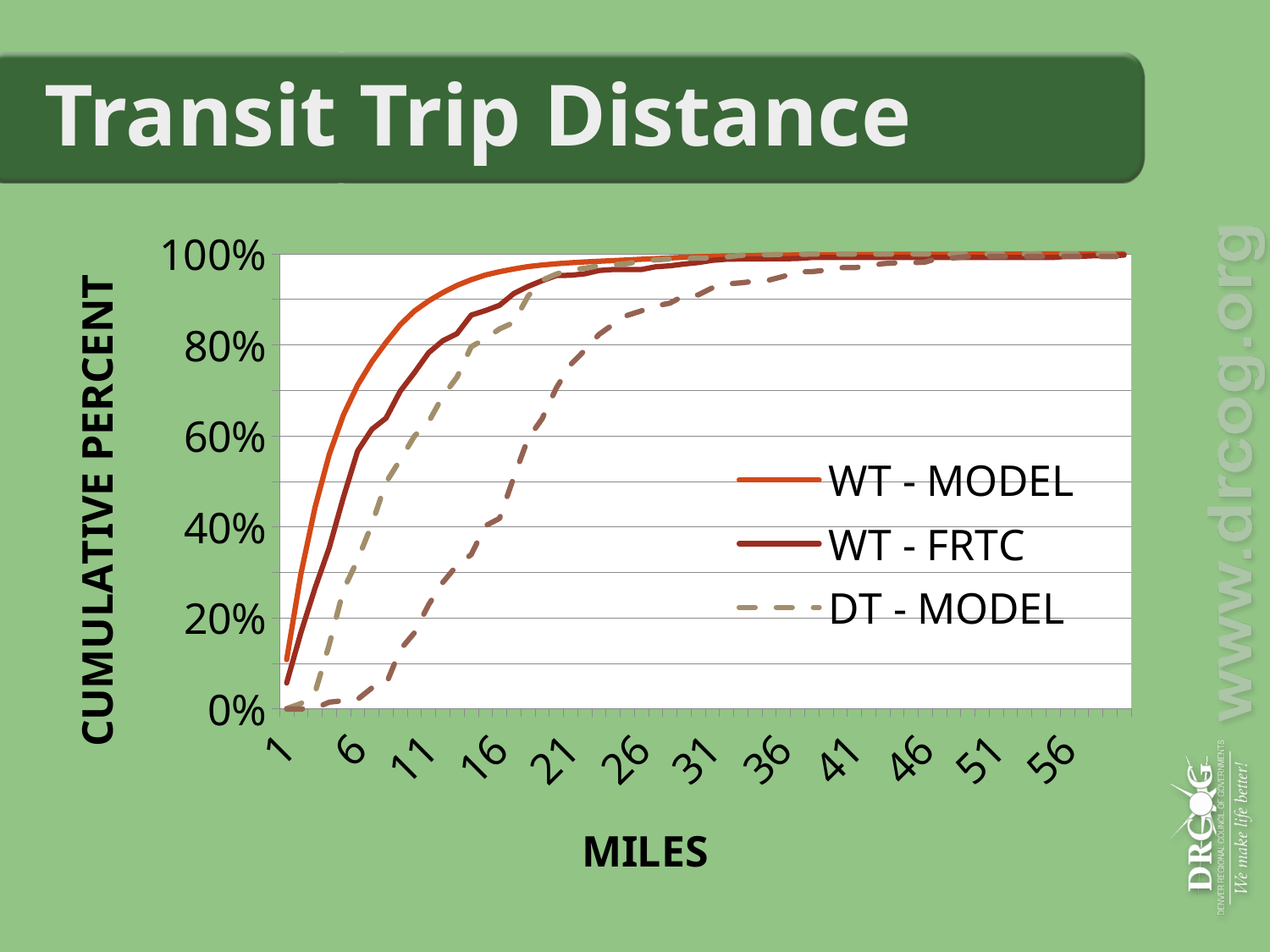
At 6 miles, which series has the larger value, WT - MODEL or DT - MODEL? WT - MODEL Is the value for DT - MODEL at 6 miles greater or less than 40%? less Is the value for WT - MODEL at 16 miles greater or less than 80%? greater Is the value for WT - MODEL at 6 miles greater or less than 60%? greater Do the values of the WT - MODEL series rise or fall as miles increase? rise What kind of chart is shown on the slide? line chart At 11 miles, which series has the larger value, WT - FRTC or DT - MODEL? WT - FRTC How many series does the legend list? 3 What is the title of the chart on the slide? Transit Trip Distance How many tick labels are shown on the x axis? 12 What is the label of the x axis? MILES